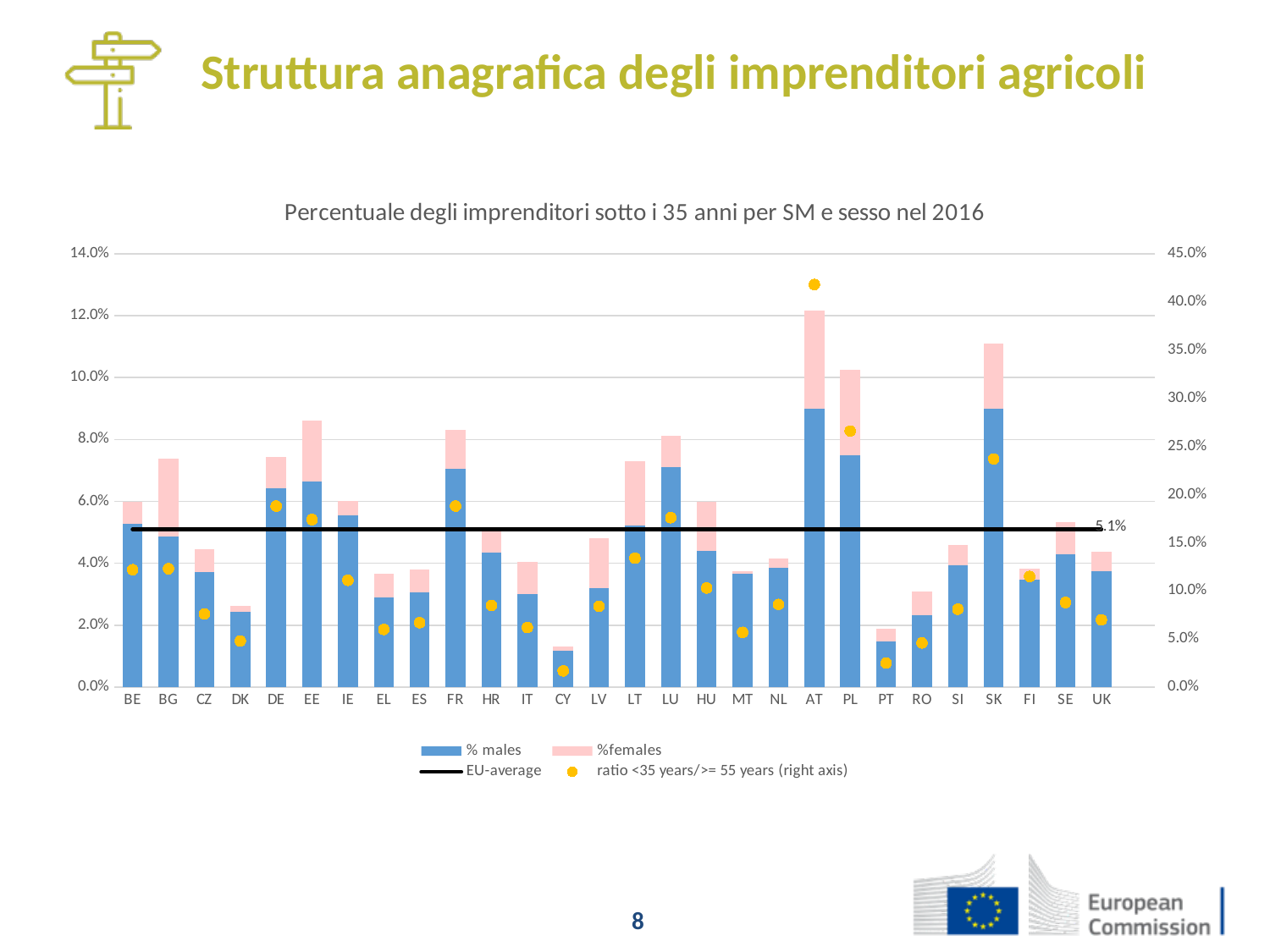
What value is printed for the EU-average line on the chart? 5.1% What is the title of the chart? Percentuale degli imprenditori sotto i 35 anni per SM e sesso nel 2016 Which country has the tallest stacked bar (highest total share of entrepreneurs under 35)? AT Which has the taller stacked bar, AT or PL? AT Is the ratio <35 years/>= 55 years dot for AT greater or less than 40.0% on the right axis? greater Which country has the shortest stacked bar (lowest total share of entrepreneurs under 35)? CY Which country has the highest ratio <35 years/>= 55 years dot (right axis)? AT How many countries (categories) are shown on the x axis? 28 Is the total stacked bar for AT greater or less than 10.0%? greater Which has the taller stacked bar, DE or DK? DE Is the total stacked bar for CY greater or less than 2.0%? less How many entries does the legend list? 4